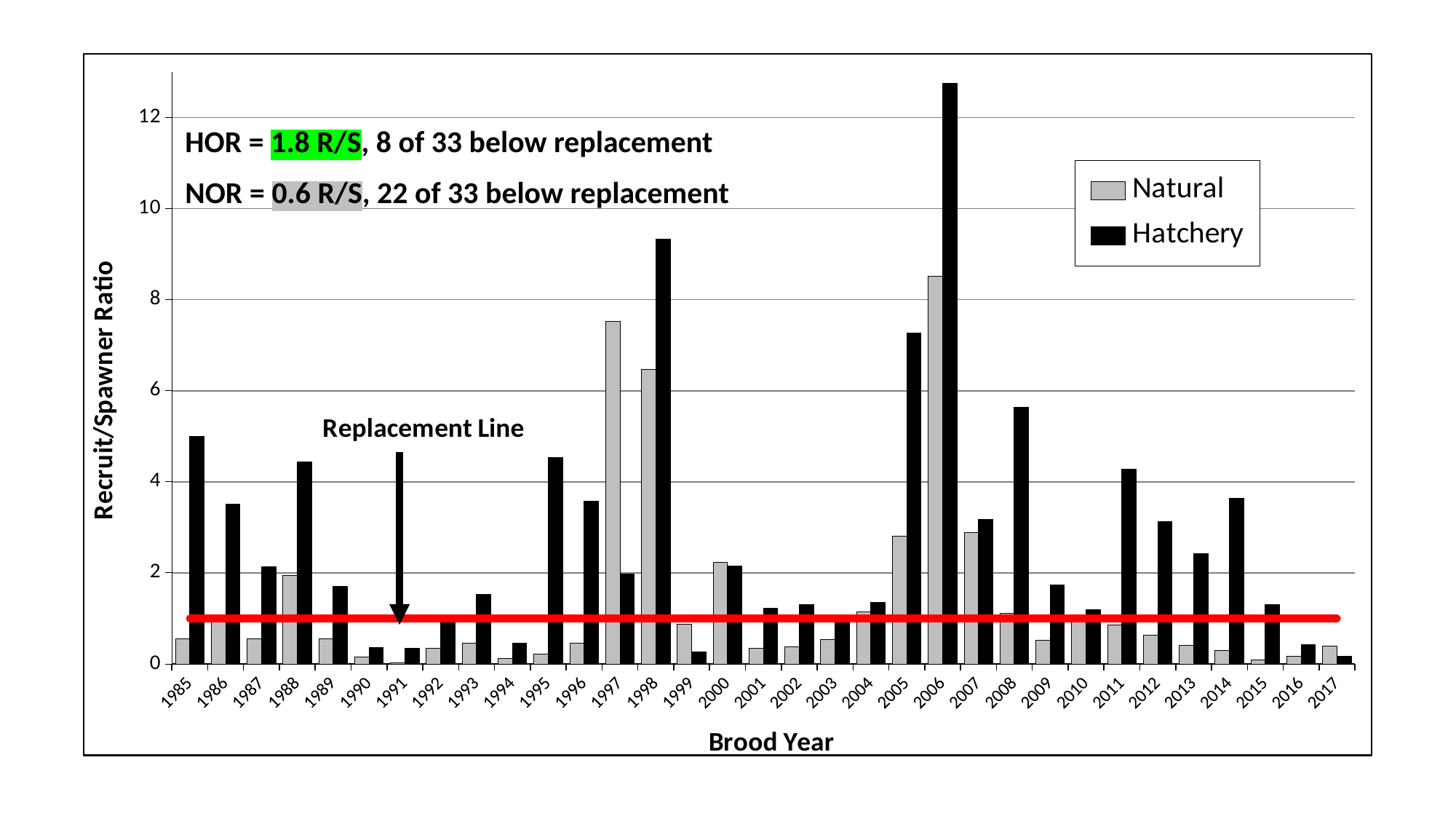
How many series does the legend list? 2 How many brood years are shown along the x axis? 33 In 2005, which is larger, the Natural or the Hatchery value? Hatchery Which brood year has the highest Natural recruit/spawner ratio? 2006 What are the two entries in the chart's legend? Natural and Hatchery Is the Hatchery value for 1998 greater or less than 8? greater Is the Natural value for 1997 greater or less than 6? greater Is the Hatchery value for 2006 greater or less than 12? greater Which brood year has the highest Hatchery recruit/spawner ratio? 2006 What kind of chart is shown on the slide? Bar chart In 1997, which is larger, the Natural or the Hatchery value? Natural